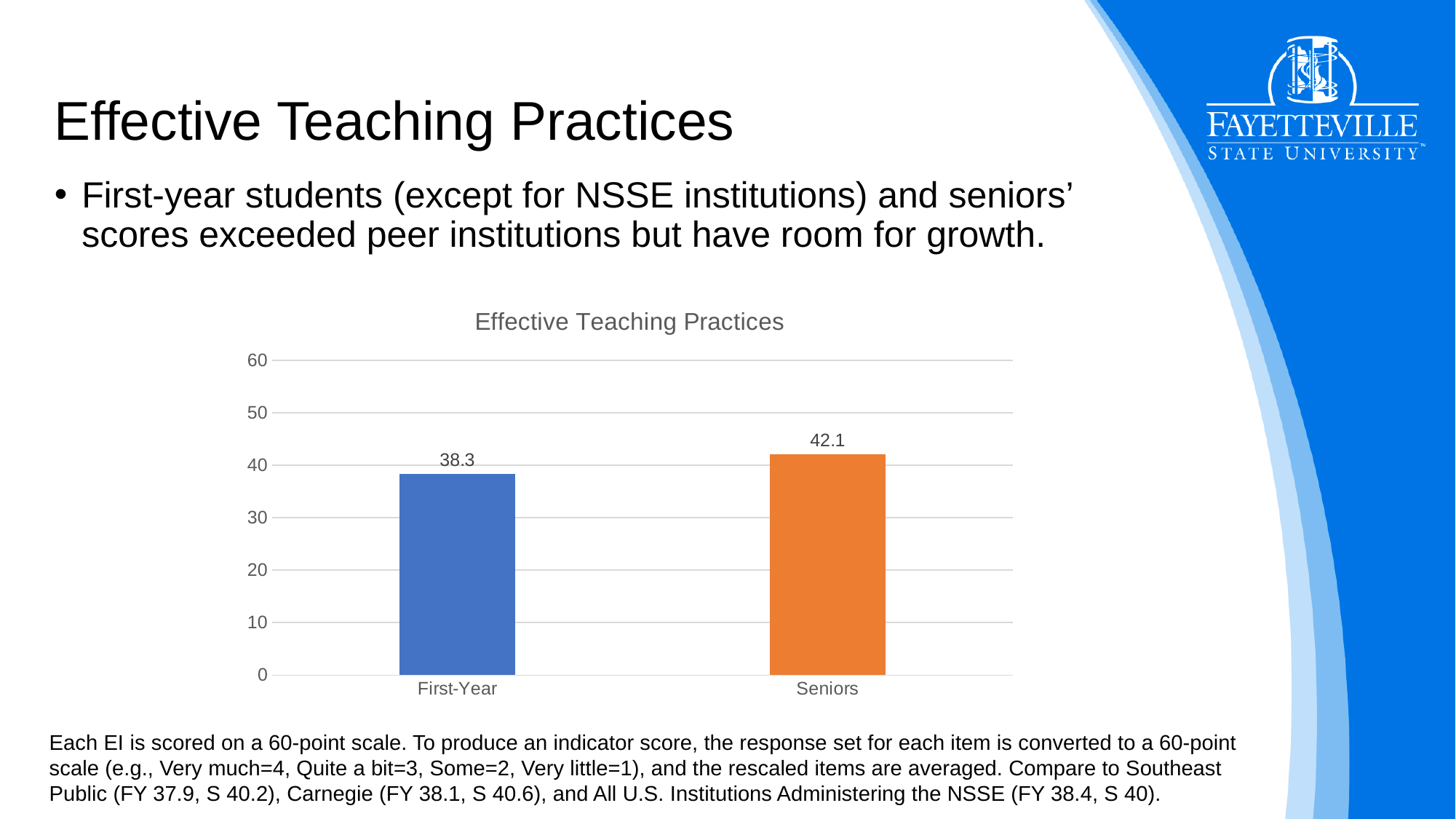
Is the value for Seniors greater or less than 40? greater Is the value for First-Year greater or less than 40? less What is the value for First-Year in the Effective Teaching Practices chart? 38.3 Which category has the highest value in the chart? Seniors What is the value for Seniors in the Effective Teaching Practices chart? 42.1 How many categories are shown on the x axis of the chart? 2 Which category has the lowest value in the chart? First-Year What kind of chart is shown on the slide? bar chart Which is larger, the value for First-Year or the value for Seniors? Seniors What is the maximum value shown on the chart's vertical axis? 60 What is the difference between the Seniors and First-Year values? 3.8 What is the title of the chart? Effective Teaching Practices